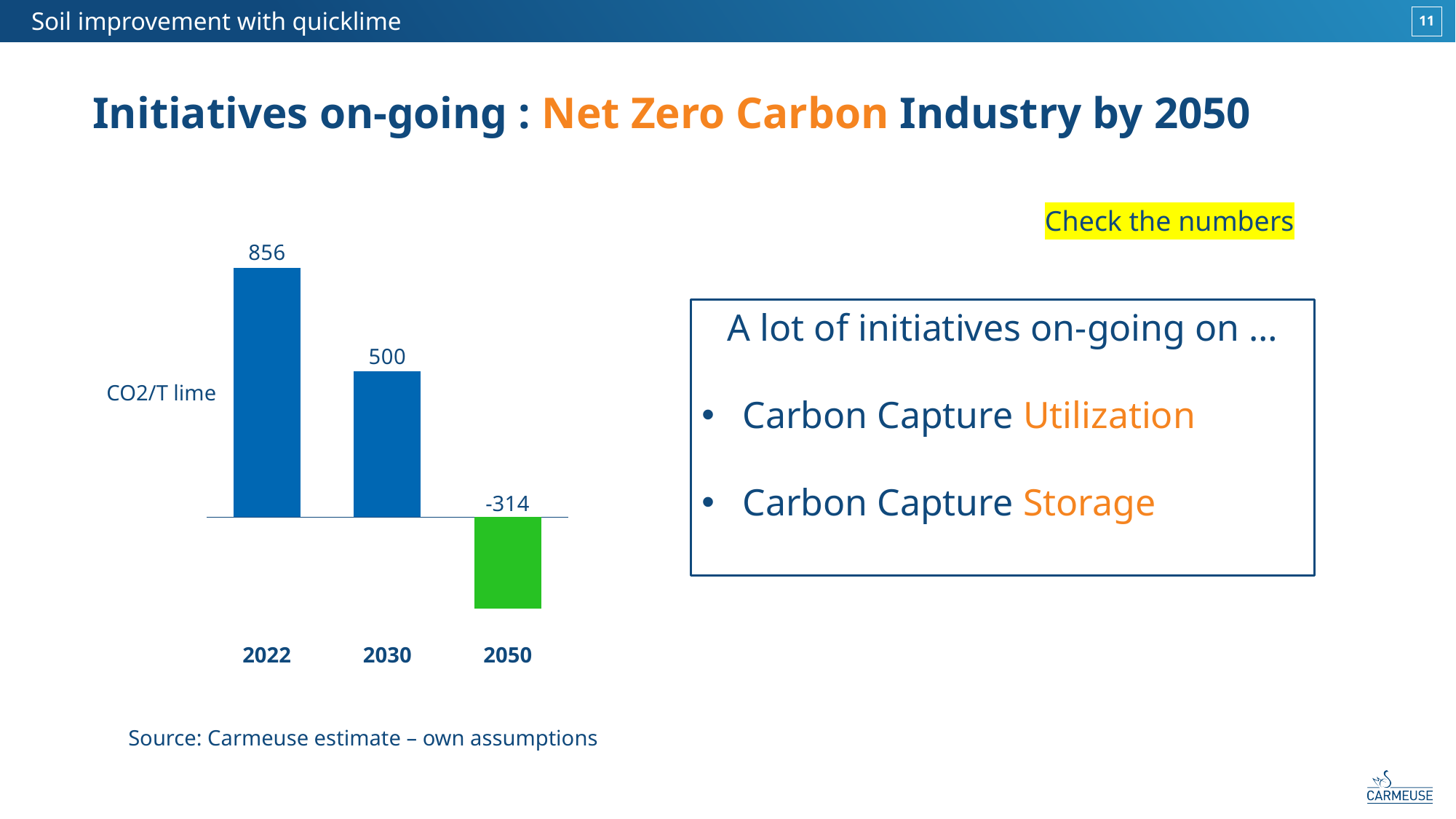
What colour is the bar for 2050? Green Which is larger, the value for 2022 or the value for 2030? 2022 Which year has the lowest CO2/T lime value? 2050 What kind of chart is shown on the slide? Bar chart How many years are shown on the chart? 3 Do the values rise or fall from 2022 to 2050? Fall What is the CO2/T lime value for 2050? -314 What is the difference between the 2030 and 2050 values? 814 What is the difference between the 2022 and 2030 values? 356 What is the CO2/T lime value for 2030? 500 Which year has the highest CO2/T lime value? 2022 What is the CO2/T lime value for 2022? 856